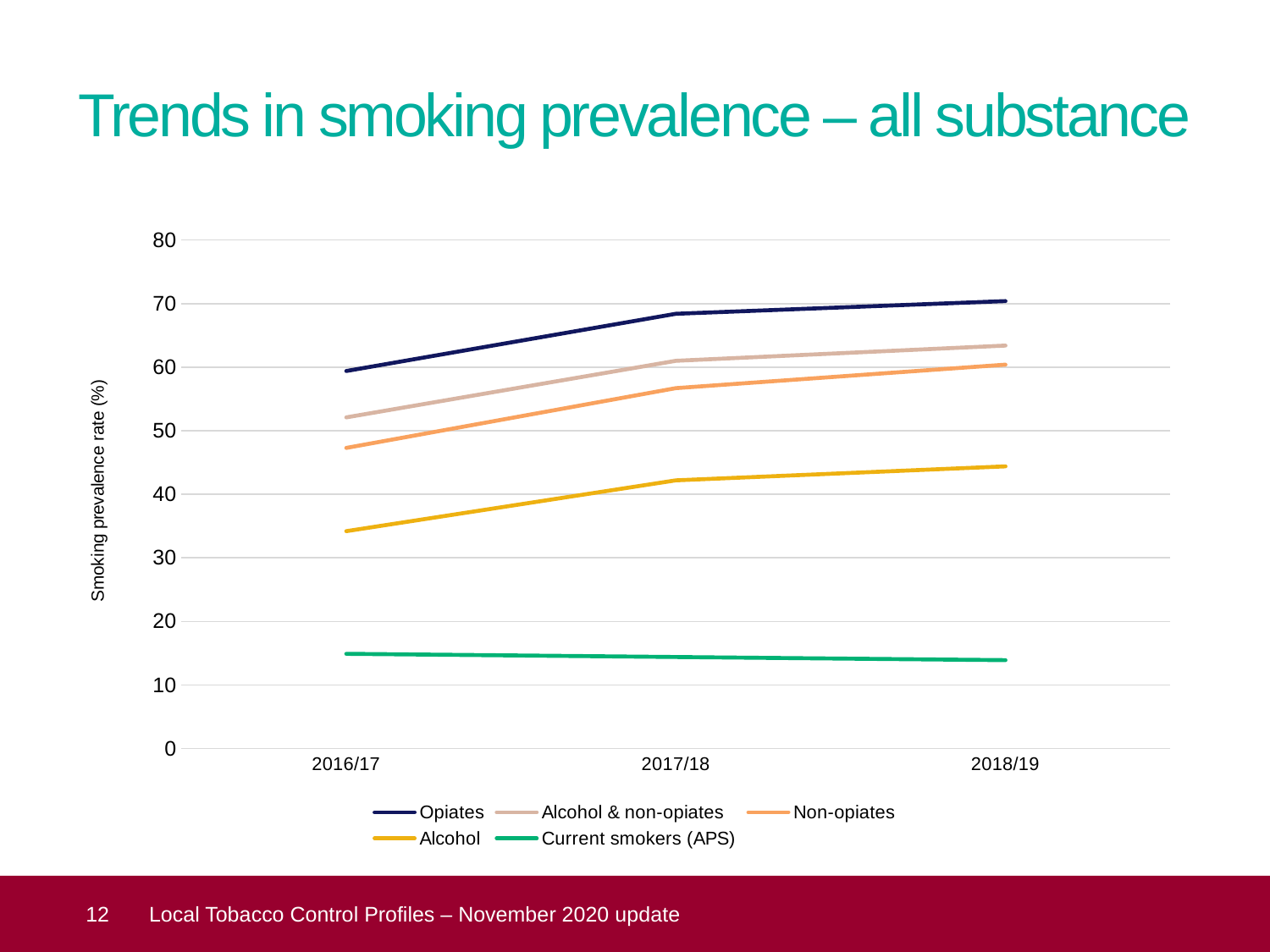
Does the Opiates line rise or fall from 2016/17 to 2018/19? rise What is the label on the y axis of the chart? Smoking prevalence rate (%) What kind of chart is shown on the slide? line chart Is the value for Alcohol & non-opiates in 2018/19 greater or less than 60? greater Which series has the lowest smoking prevalence rate in 2016/17? Current smokers (APS) Is the value for Opiates in 2016/17 greater or less than 50? greater Which is larger in 2017/18, the value for Non-opiates or the value for Alcohol? Non-opiates Is the value for Current smokers (APS) in 2018/19 greater or less than 20? less How many series does the legend list? 5 How many time periods are shown on the x axis? 3 Which series has the highest smoking prevalence rate in 2018/19? Opiates